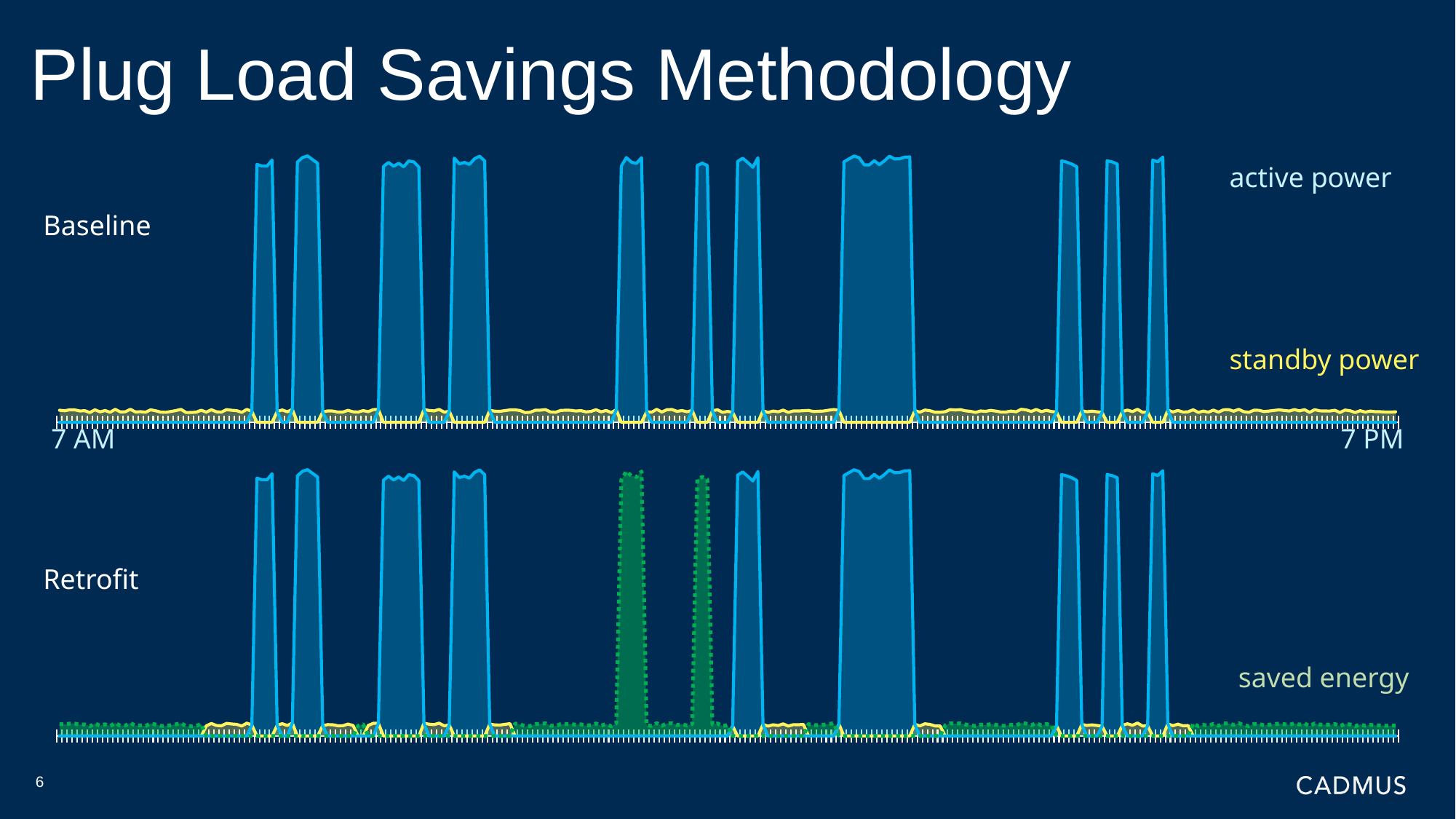
In the Retrofit chart, what colour is the saved energy series? green In the Baseline chart, what colour is the standby power series? yellow Which chart, Baseline or Retrofit, shows saved energy? Retrofit What kind of chart is the Baseline chart? area and line chart In the Baseline chart, how many active power peaks are plotted? 11 What time does the x axis of the Baseline chart start at? 7 AM How many charts are shown on the slide? 2 In the Retrofit chart, how many green saved energy peaks are plotted? 2 What time does the x axis of the Baseline chart end at? 7 PM In the Baseline chart, which is higher, active power or standby power? active power